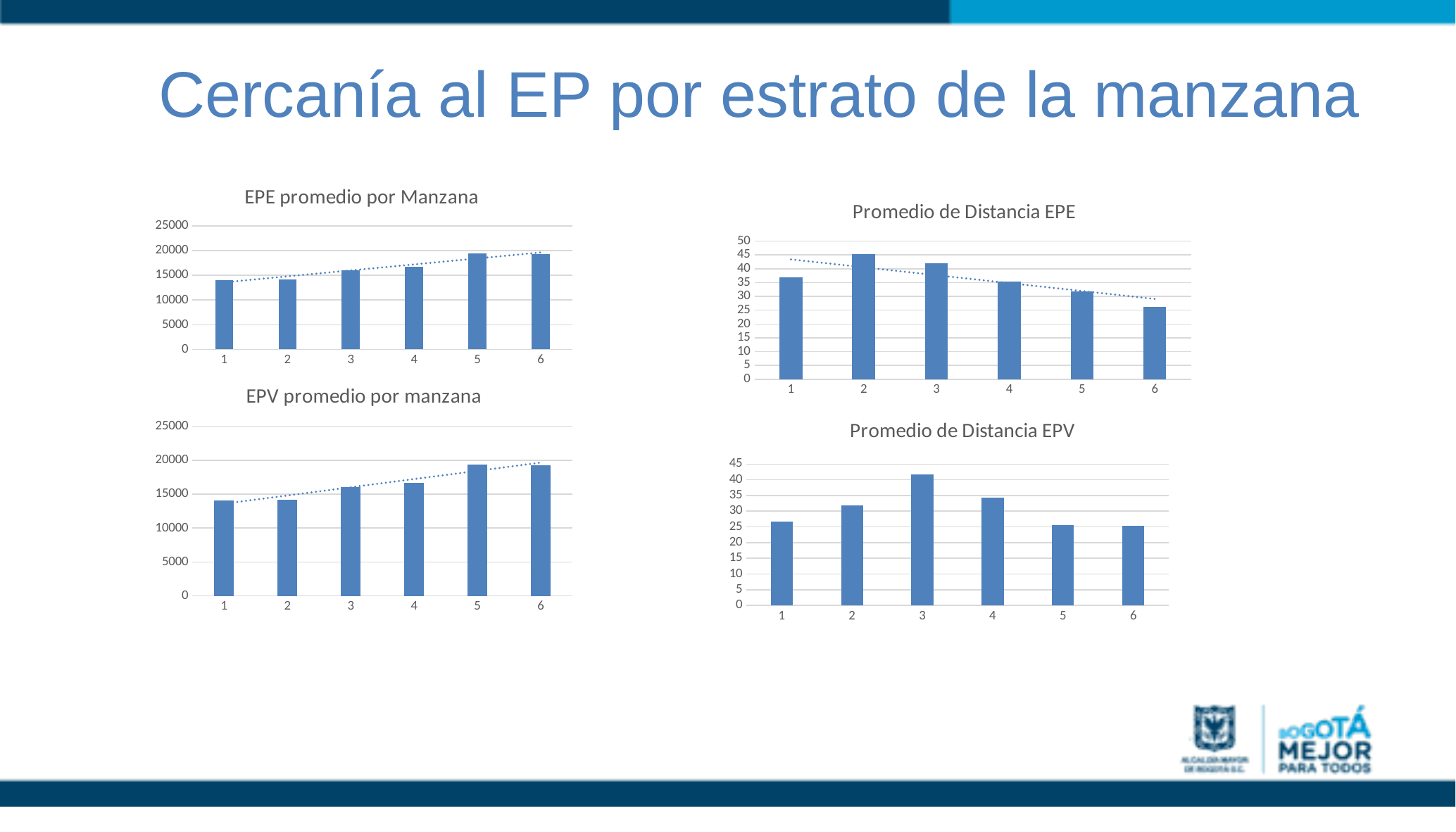
In the chart titled "Promedio de Distancia EPE", which category has the lowest value? 6 What kind of chart is the chart titled "EPV promedio por manzana"? bar chart In the chart titled "Promedio de Distancia EPV", is the value for category 3 greater or less than 40? greater In the chart titled "Promedio de Distancia EPE", is the value for category 6 greater or less than 30? less In the chart titled "Promedio de Distancia EPV", which category has the highest value? 3 In the chart titled "Promedio de Distancia EPE", is the value for category 2 greater or less than 40? greater In the chart titled "Promedio de Distancia EPE", do the values generally rise or fall from category 1 to category 6? fall In the chart titled "Promedio de Distancia EPV", which is larger, the value for category 2 or the value for category 5? 2 How many categories are shown on the x axis of the chart titled "EPV promedio por manzana"? 6 In the chart titled "EPE promedio por Manzana", do the values generally rise or fall from category 1 to category 6? rise In the chart titled "Promedio de Distancia EPE", which category has the highest value? 2